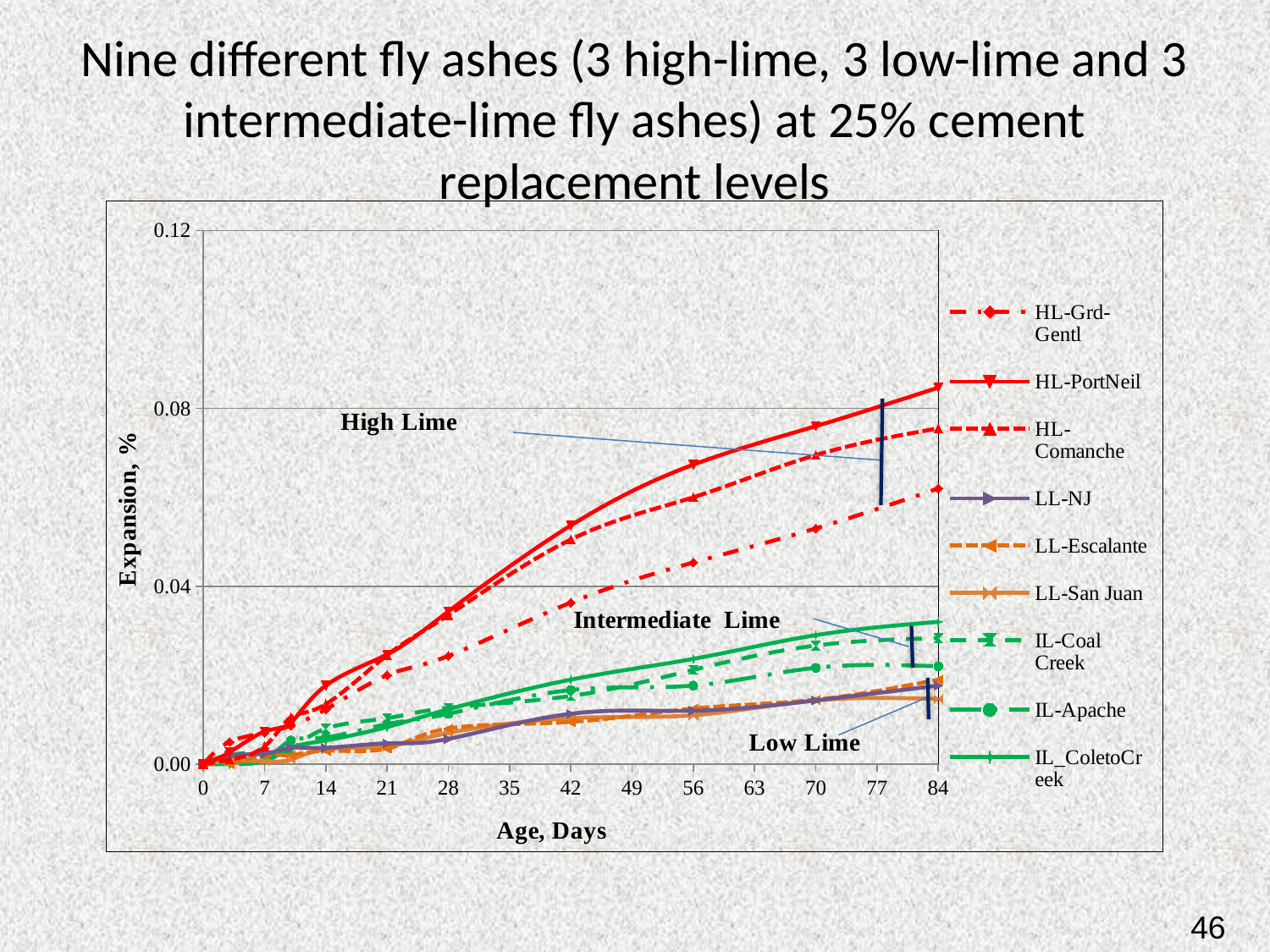
What kind of chart is shown on the slide? line chart What is the label of the y axis? Expansion, % Do the expansion values rise or fall as age in days increases? rise Is the expansion for HL-Comanche at 56 days greater or less than 0.04? greater What is the label of the x axis? Age, Days Which is larger at 84 days, the expansion for HL-PortNeil or for HL-Grd-Gentl? HL-PortNeil Is the expansion for HL-PortNeil at 84 days greater or less than 0.08? greater How many series does the legend list? 9 Which is larger at 84 days, the expansion for HL-Comanche or for LL-NJ? HL-Comanche Which series has the highest expansion at 84 days? HL-PortNeil Is the expansion for IL_ColetoCreek at 84 days greater or less than 0.04? less